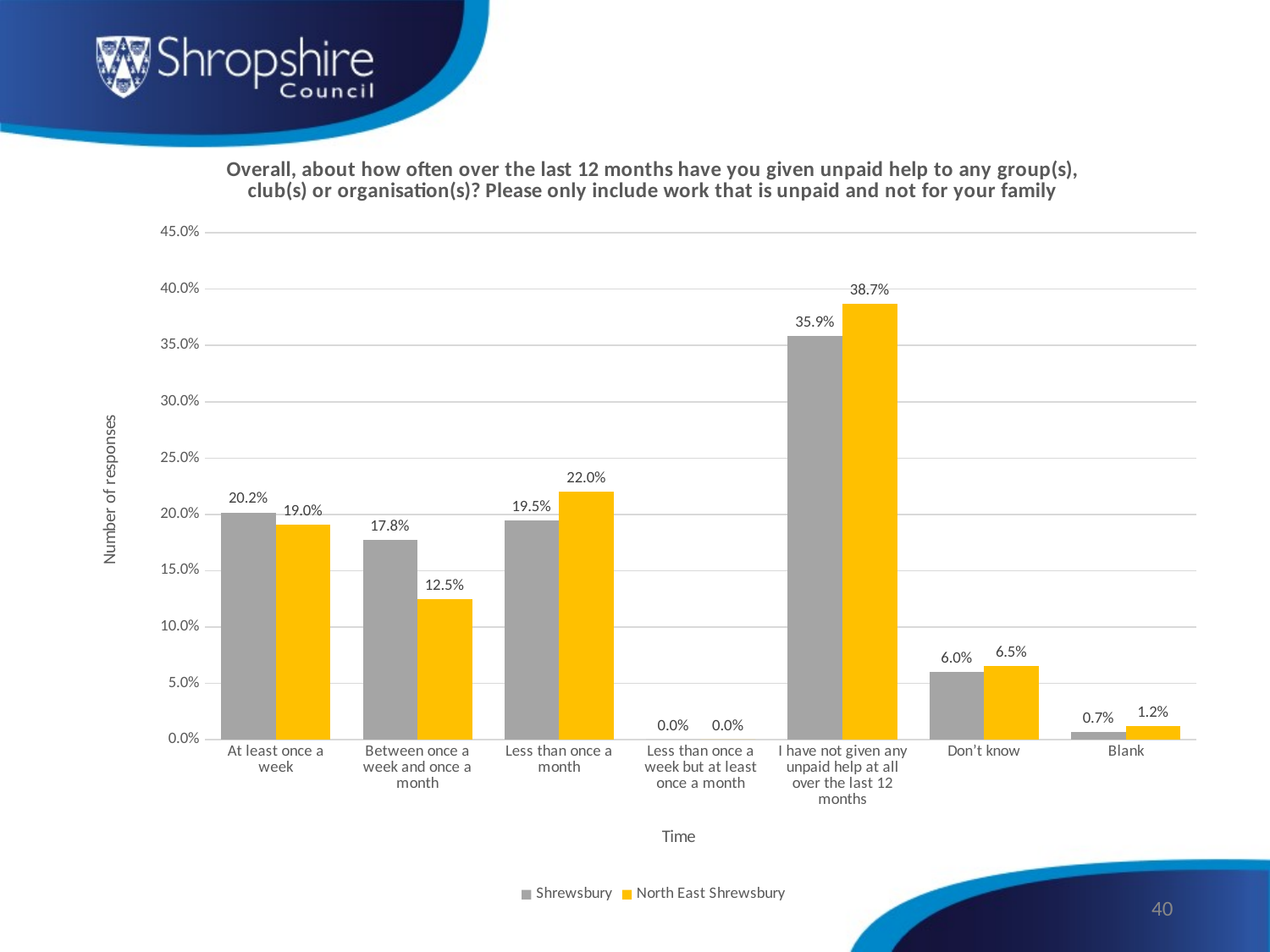
What is the difference between the Shrewsbury and North East Shrewsbury values in the 'Between once a week and once a month' category? 5.3% Which category has the highest value for Shrewsbury? I have not given any unpaid help at all over the last 12 months What is the label of the y axis? Number of responses What is the value for North East Shrewsbury in the 'Between once a week and once a month' category? 12.5% What is the value for Shrewsbury in the 'At least once a week' category? 20.2% Which category has the lowest value for North East Shrewsbury? Less than once a week but at least once a month What is the value for North East Shrewsbury in the 'I have not given any unpaid help at all over the last 12 months' category? 38.7% How many categories are shown on the x axis? 7 What kind of chart is shown on the slide? Bar chart What is the value for Shrewsbury in the 'Blank' category? 0.7% How many series does the legend list? 2 In the 'Less than once a month' category, which series has the larger value, Shrewsbury or North East Shrewsbury? North East Shrewsbury